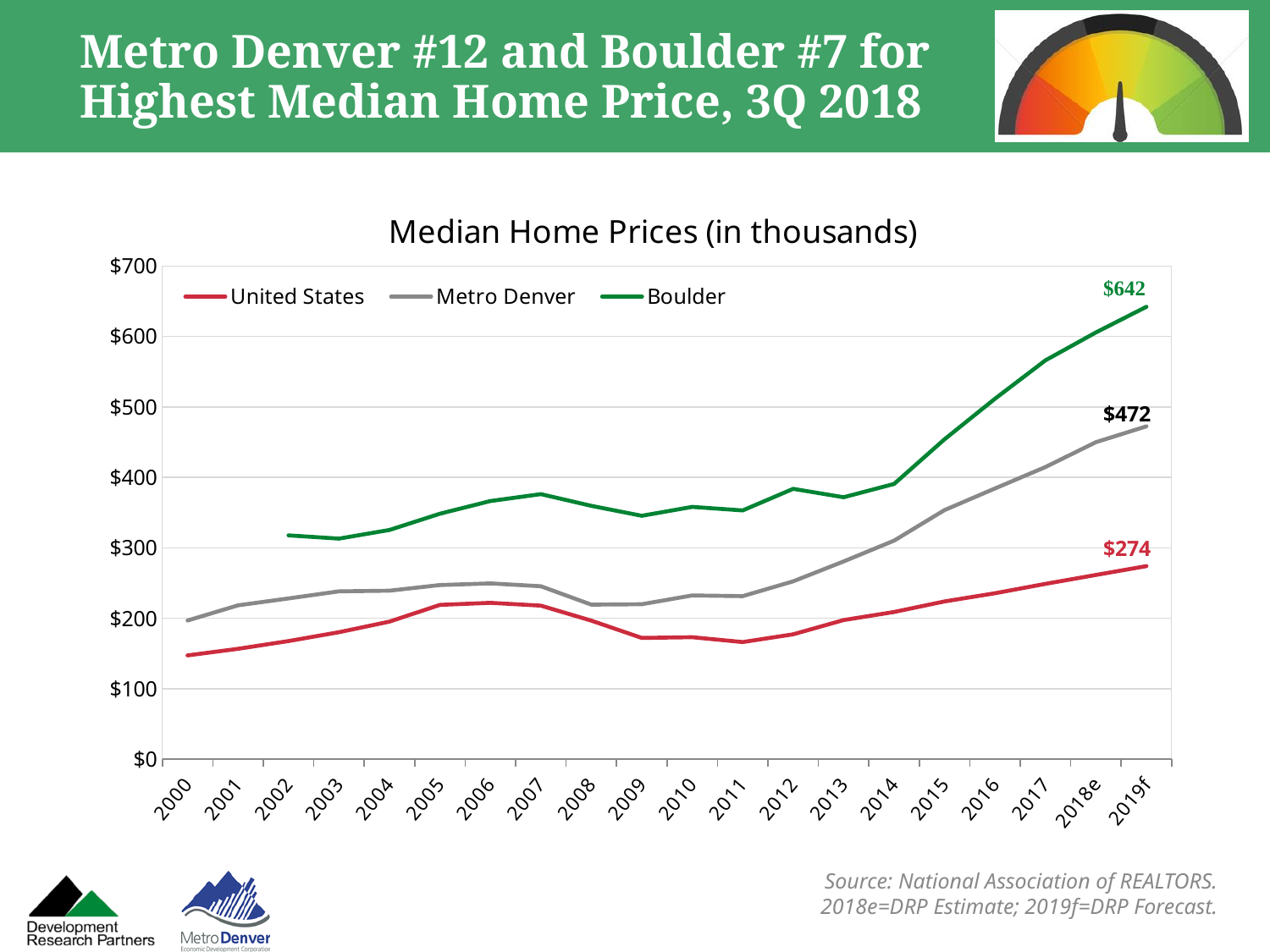
What is the value for United States in 2019f? $274 Which series has the lowest value in 2019f? United States What is the value for Boulder in 2019f? $642 What kind of chart is shown on the slide? line chart Is the value for Boulder in 2007 greater or less than $300? greater Is the value for United States in 2000 greater or less than $200? less Which series has the highest value in 2019f? Boulder Does the Boulder line rise or fall from 2014 to 2019f? rise What is the value for Metro Denver in 2019f? $472 What is the difference between the Boulder and Metro Denver values in 2019f? $170 How many series does the legend list? 3 What is the difference between the Metro Denver and United States values in 2019f? $198